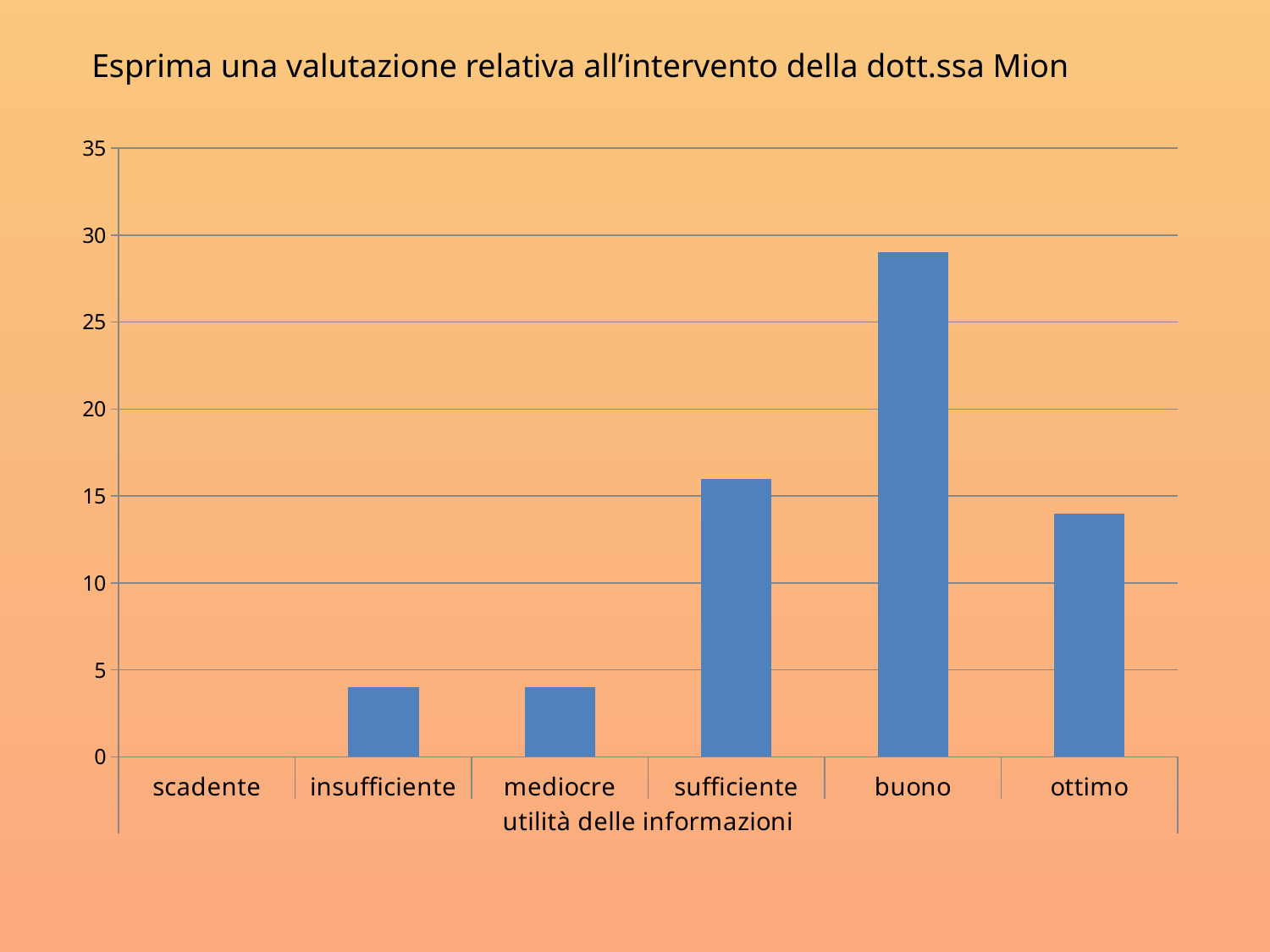
How many categories are shown on the x axis? 6 What is the title of the chart? Esprima una valutazione relativa all'intervento della dott.ssa Mion What is the label of the x axis? utilità delle informazioni Is the value for sufficiente greater or less than 10? greater What kind of chart is shown on the slide? bar chart Which is larger, the value for buono or the value for ottimo? buono Is the value for insufficiente greater or less than 5? less Is the value for buono greater or less than 30? less Which category has the highest value? buono